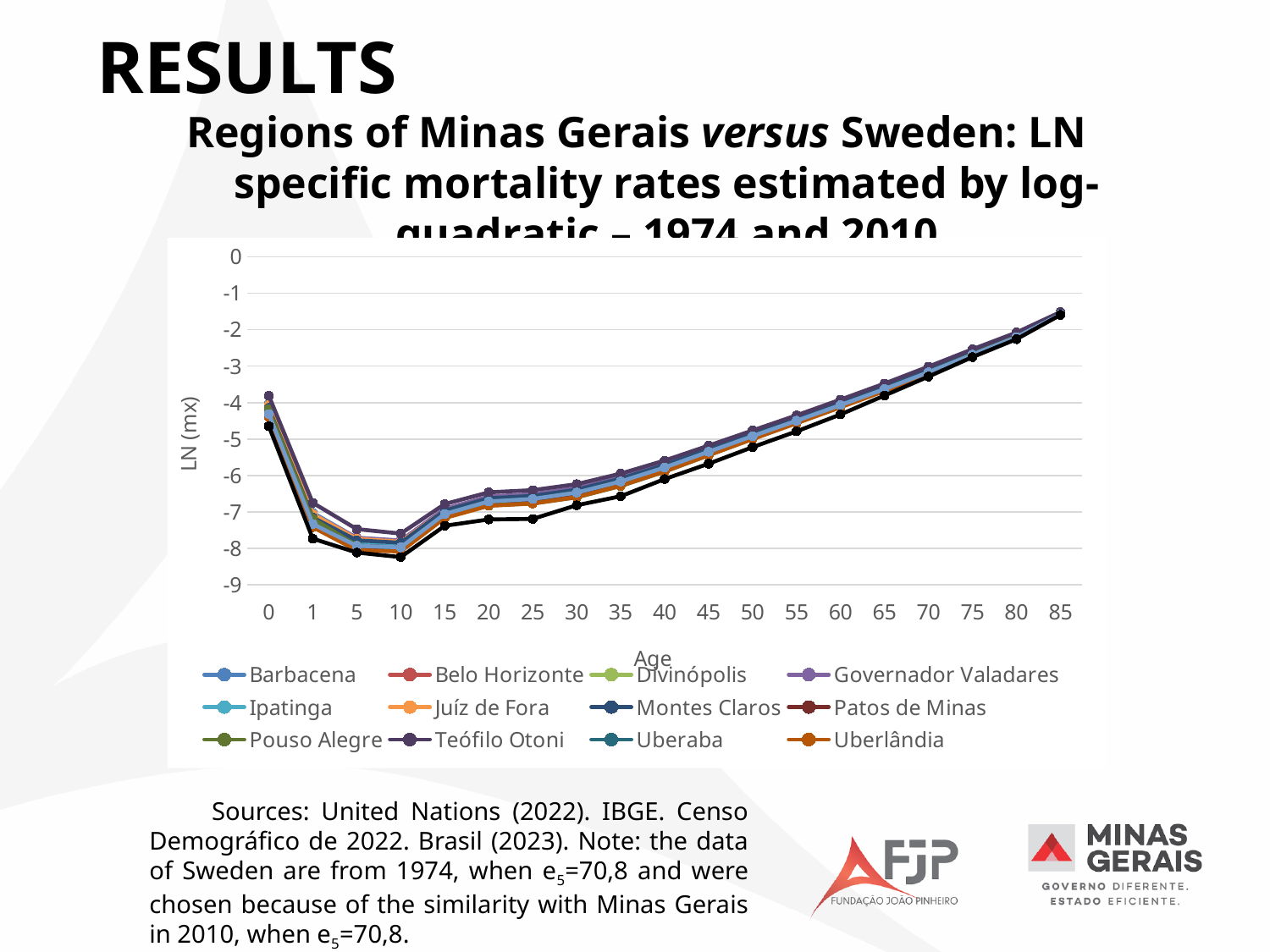
What is the label of the y axis? LN (mx) What kind of chart is shown on the slide? line chart Do the values rise or fall along the x axis from age 10 to age 85? rise How many age categories are shown on the x axis? 18 Is the value for Uberlândia at age 50 greater or less than -6? greater Is the value for Belo Horizonte at age 10 greater or less than -7? less Is the value for Ipatinga at age 1 greater or less than -6? less Do the values rise or fall from age 0 to age 1? fall How many series does the legend list? 12 At which age do the lines reach their highest value? 85 What is the label of the x axis? Age